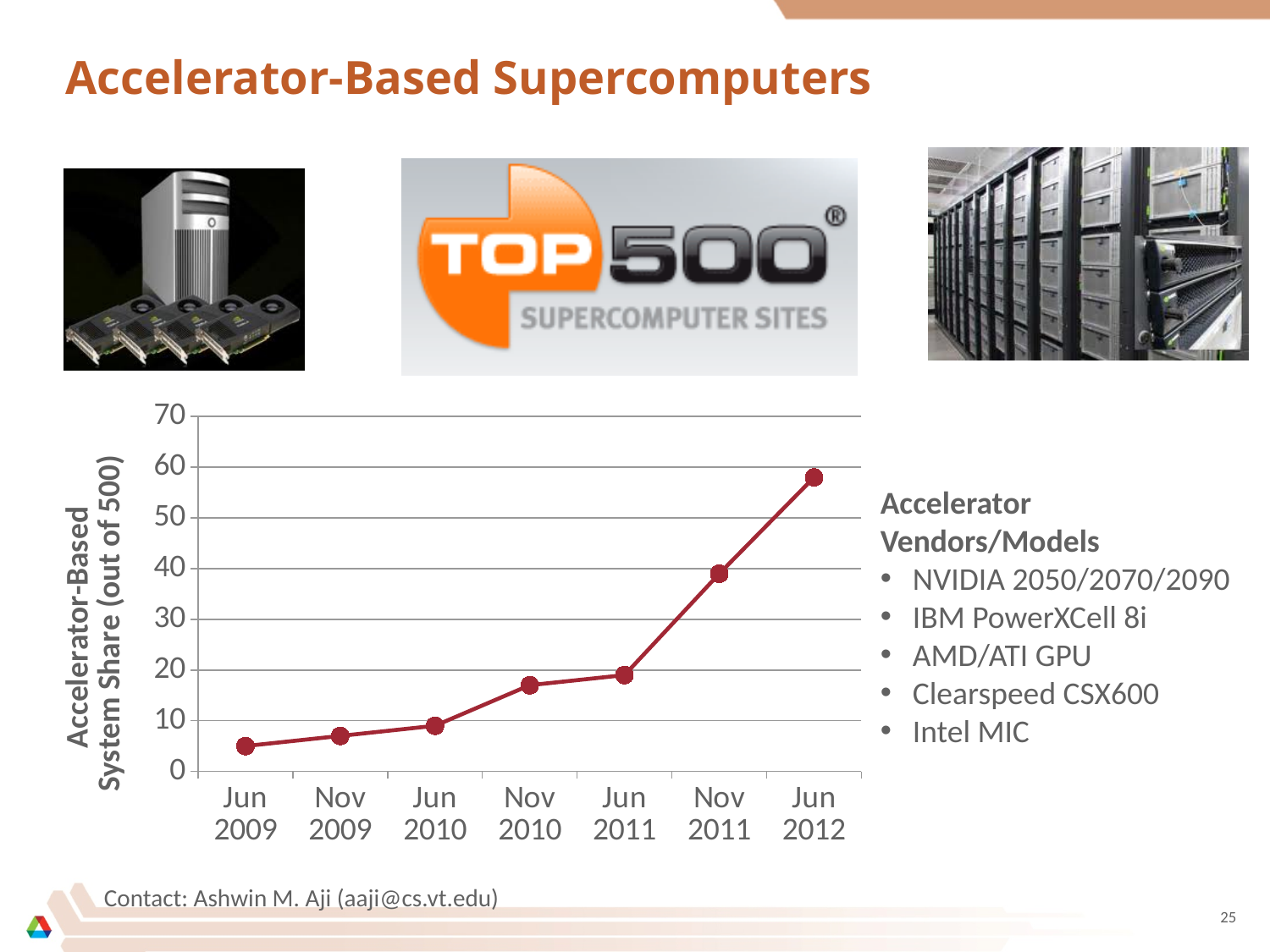
Is the value for Jun 2009 greater or less than 10? less Is the value for Jun 2012 greater or less than 50? greater Is the value for Nov 2010 greater or less than 20? less Which date has the highest accelerator-based system share? Jun 2012 How many data points are plotted on the line chart? 7 Do the values rise or fall from Jun 2009 to Jun 2012? rise Which date has the lowest accelerator-based system share? Jun 2009 What kind of chart is shown on the slide? line chart Which is larger, the value for Nov 2011 or the value for Jun 2011? Nov 2011 What is the highest tick value shown on the vertical axis? 70 What is the label of the vertical axis of the chart? Accelerator-Based System Share (out of 500)